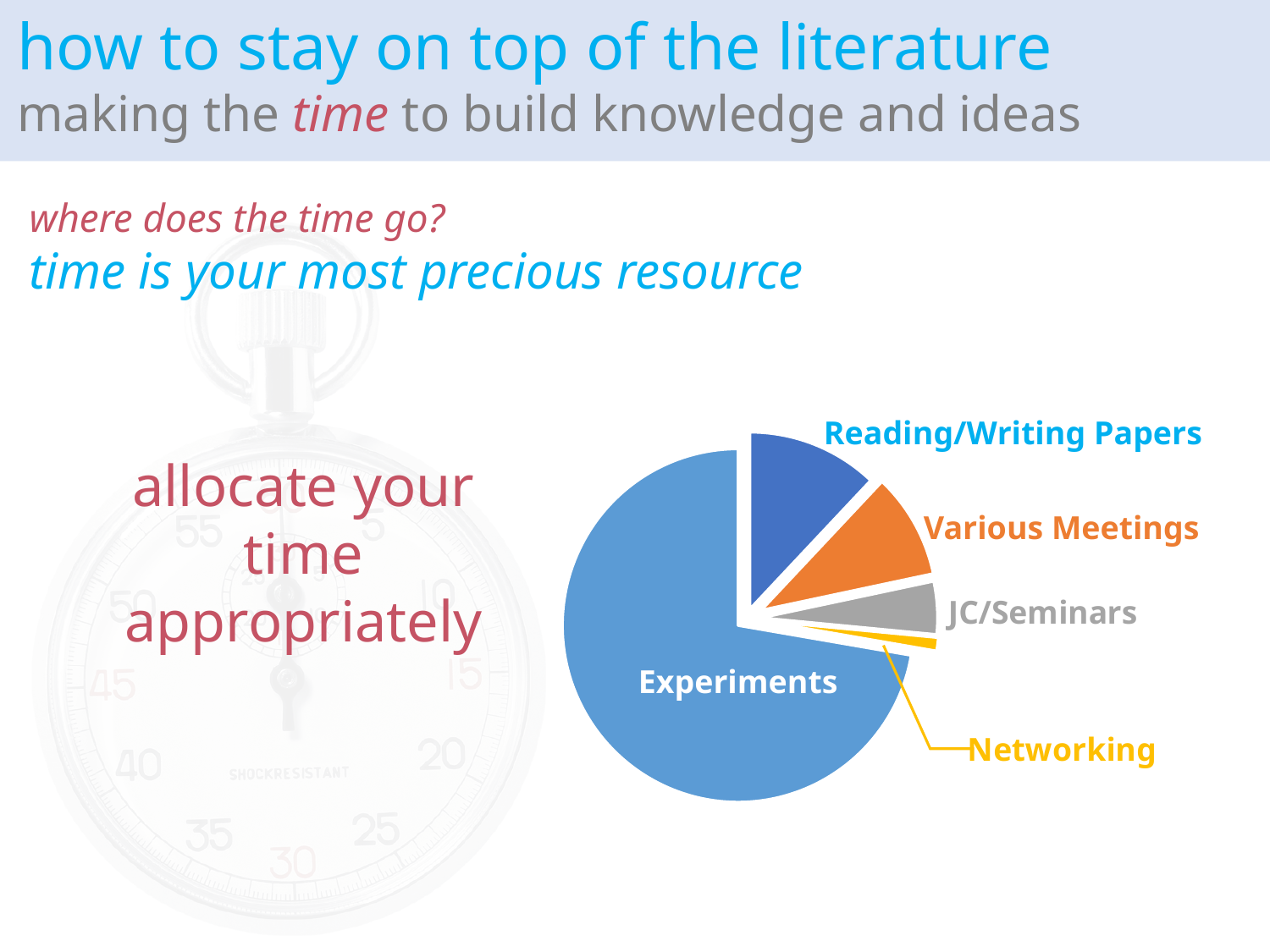
Which slice is larger, Experiments or Reading/Writing Papers? Experiments Which category takes up the largest share of the pie chart? Experiments Which slice is larger, Various Meetings or JC/Seminars? Various Meetings Which slice is larger, JC/Seminars or Networking? JC/Seminars Which category takes up the smallest share of the pie chart? Networking What kind of chart is shown on the slide? pie chart Which category's label is connected to its slice by a leader line? Networking What colour is the Various Meetings slice in the pie chart? orange How many slices does the pie chart have? 5